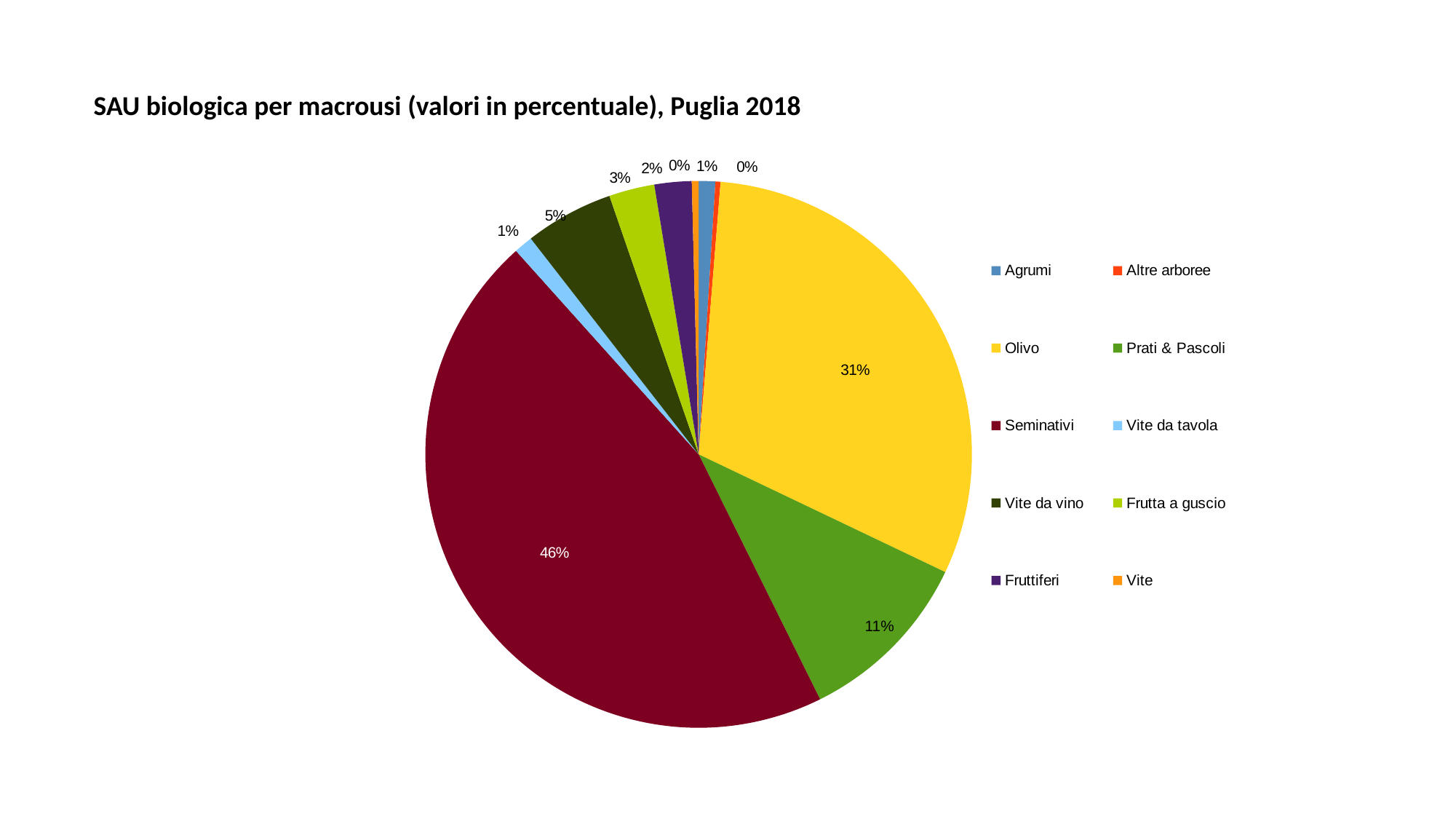
What percentage is labelled for Vite da vino? 5% What percentage is shown for Olivo? 31% What kind of chart is shown on the slide? Pie chart What is the title of the chart? SAU biologica per macrousi (valori in percentuale), Puglia 2018 What is the combined share of Seminativi and Olivo? 77% What is the difference in percentage points between Seminativi and Olivo? 15 What is the value shown for Frutta a guscio? 3% What share of the pie does Seminativi represent? 46% Which is larger, the slice for Olivo or the slice for Prati & Pascoli? Olivo What is the value for Prati & Pascoli? 11% Which category has the largest slice of the pie? Seminativi How many categories does the legend list? 10